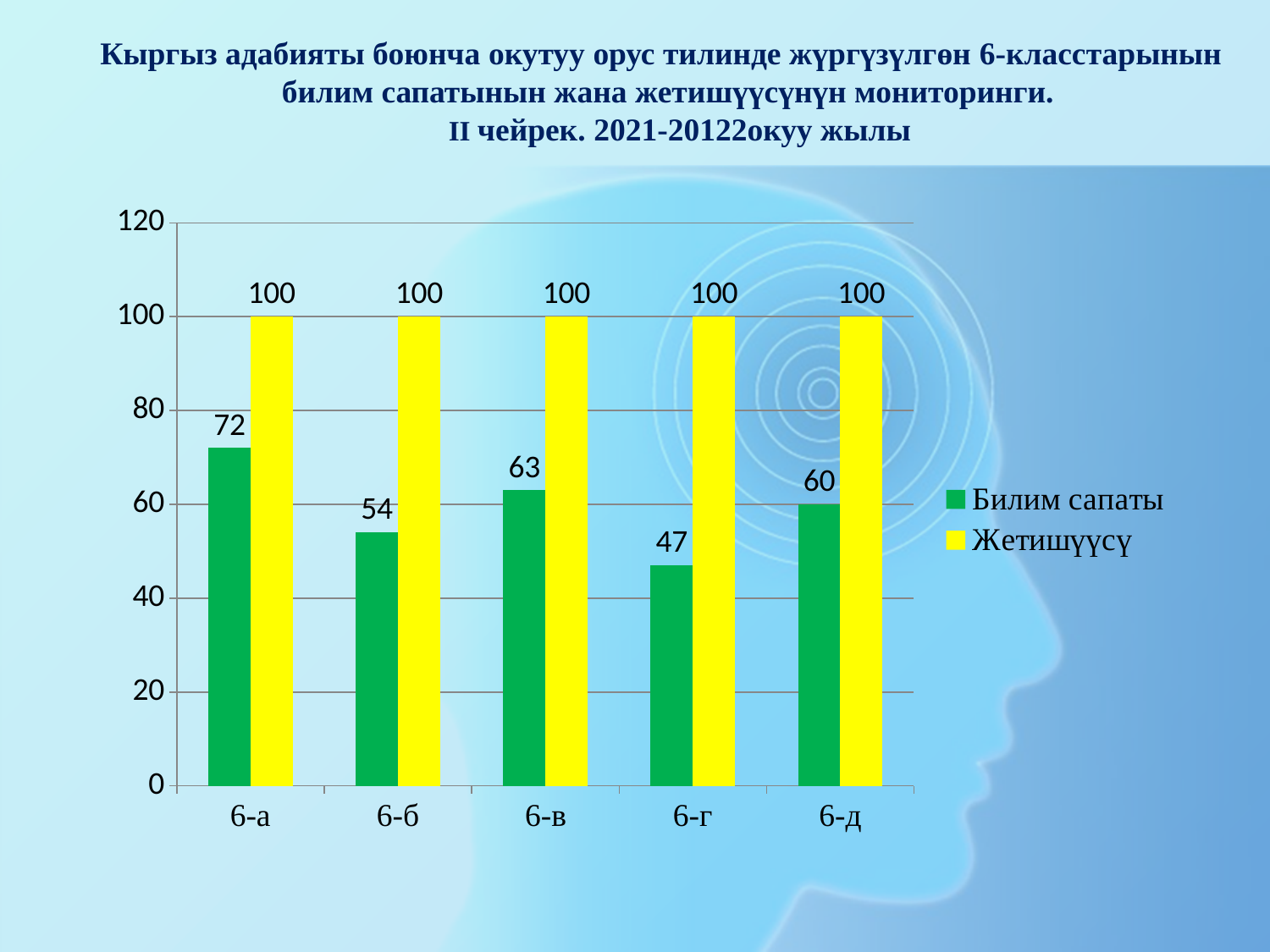
What kind of chart is shown on the slide? bar chart Which class has the highest Билим сапаты value? 6-а What is the difference between the Билим сапаты values for 6-а and 6-б? 18 What is the difference between Жетишүүсү and Билим сапаты for 6-д? 40 How many classes are shown on the x axis? 5 Which is larger, the Билим сапаты value for 6-в or for 6-д? 6-в What is the value of Билим сапаты for 6-а? 72 Which class has the lowest Билим сапаты value? 6-г What is the value of Билим сапаты for 6-г? 47 How many series does the legend list? 2 What is the value of Жетишүүсү for 6-в? 100 Which colour represents the Жетишүүсү series? yellow